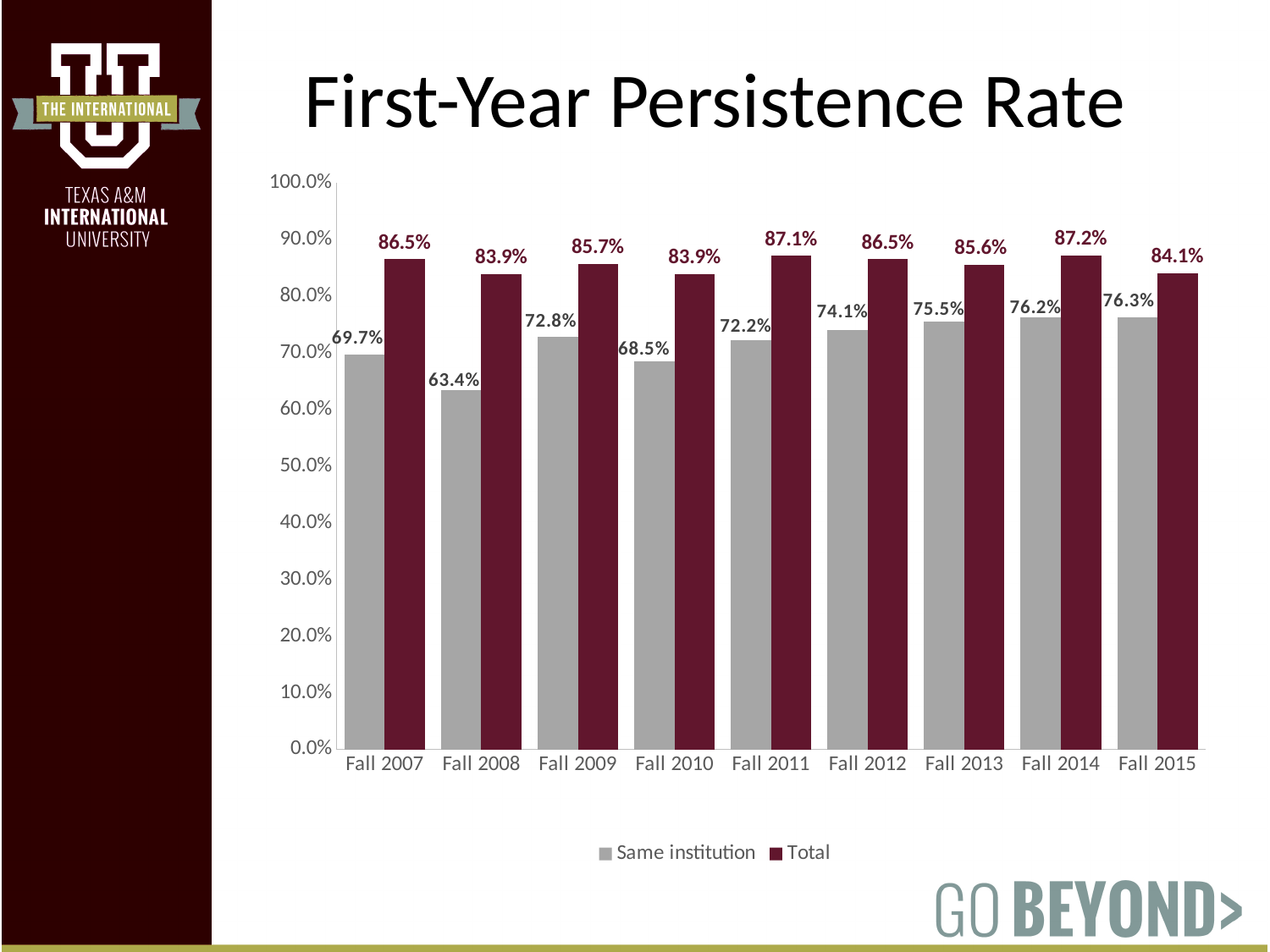
What is the Total first-year persistence rate for Fall 2014? 87.2% What is the Same institution value for Fall 2015? 76.3% What kind of chart is shown on the slide? Bar chart Which fall cohort has the lowest Same institution persistence rate? Fall 2008 How many series does the legend list? 2 What is the difference between the Total and Same institution rates for Fall 2007? 16.8% What is the Same institution first-year persistence rate for Fall 2008? 63.4% Is the Total value for Fall 2011 greater or less than 80.0%? greater Which is larger, the Same institution rate for Fall 2013 or for Fall 2010? Fall 2013 What is the title of the chart? First-Year Persistence Rate Which fall cohort has the highest Total persistence rate? Fall 2014 How many fall cohorts are shown on the x axis? 9